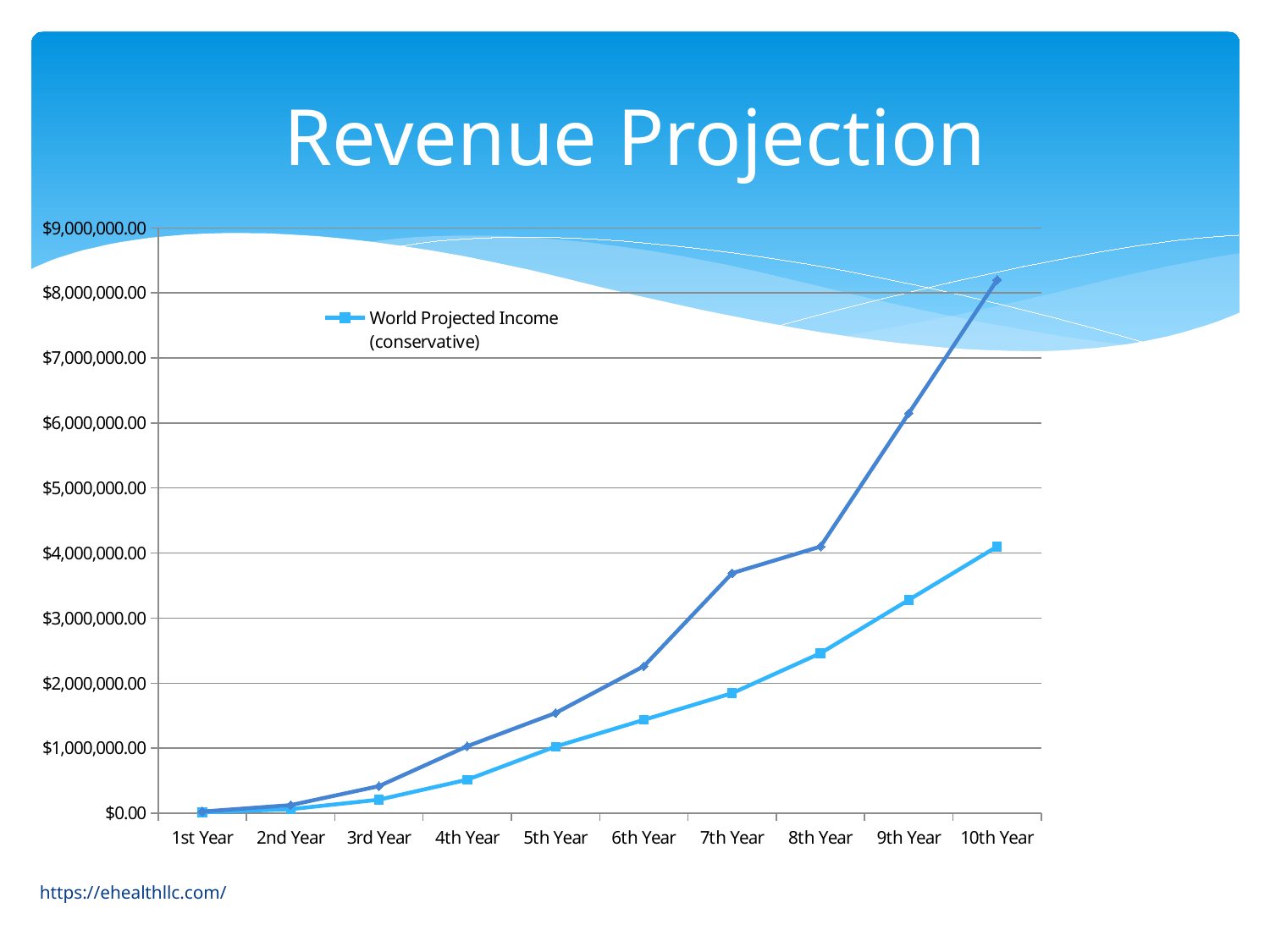
Is the value for World Projected Income (conservative) in the 4th Year greater or less than $1,000,000.00? less Is the value for World Projected Income (conservative) in the 7th Year greater or less than $2,000,000.00? less In which year is World Projected Income (conservative) highest? 10th Year How many series does the legend list? 1 What kind of chart is shown on the slide? line chart Is the value for World Projected Income (conservative) in the 9th Year greater or less than $3,000,000.00? greater What is the title of the chart? Revenue Projection Do the values for World Projected Income (conservative) rise or fall from 1st Year to 10th Year? rise In which year is World Projected Income (conservative) lowest? 1st Year How many years are shown along the x axis? 10 What series name appears in the legend? World Projected Income (conservative) Which is larger for World Projected Income (conservative): the 9th Year value or the 5th Year value? 9th Year